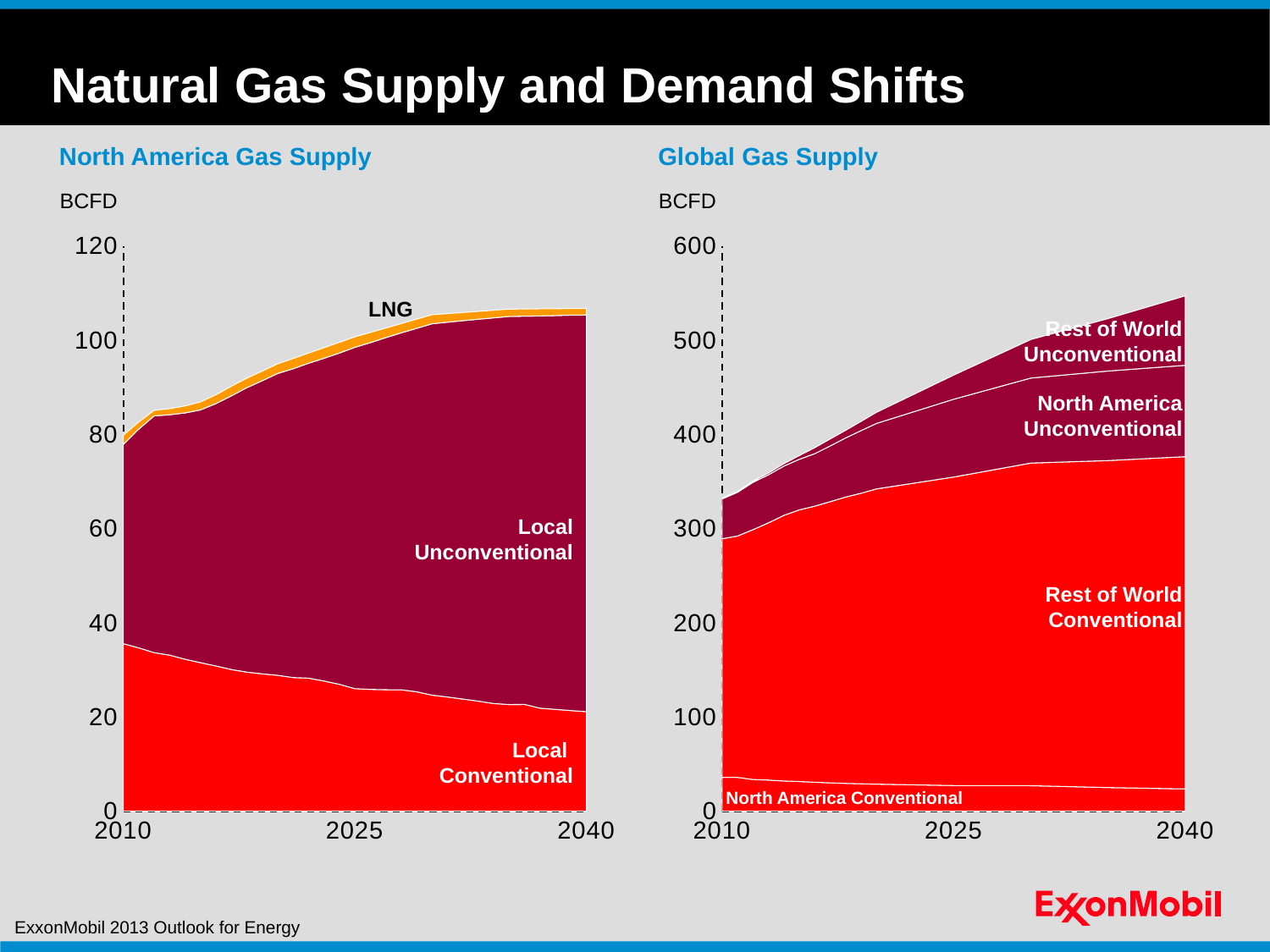
In the Global Gas Supply chart, what is the highest value shown on the y axis? 600 What kind of chart is the North America Gas Supply chart? Stacked area chart What kind of chart is the Global Gas Supply chart? Stacked area chart In the North America Gas Supply chart, does the Local Conventional series rise or fall from 2010 to 2040? fall In the North America Gas Supply chart, what unit is shown on the y axis? BCFD In the North America Gas Supply chart, is the total supply in 2040 greater or less than 100? greater In the North America Gas Supply chart, is the Local Conventional value in 2040 greater or less than 40? less In the Global Gas Supply chart, how many supply series are labelled? 4 In the Global Gas Supply chart, is the total supply in 2010 greater or less than 400? less In the Global Gas Supply chart, does the total supply rise or fall from 2010 to 2040? rise In the North America Gas Supply chart, how many supply series are labelled? 3